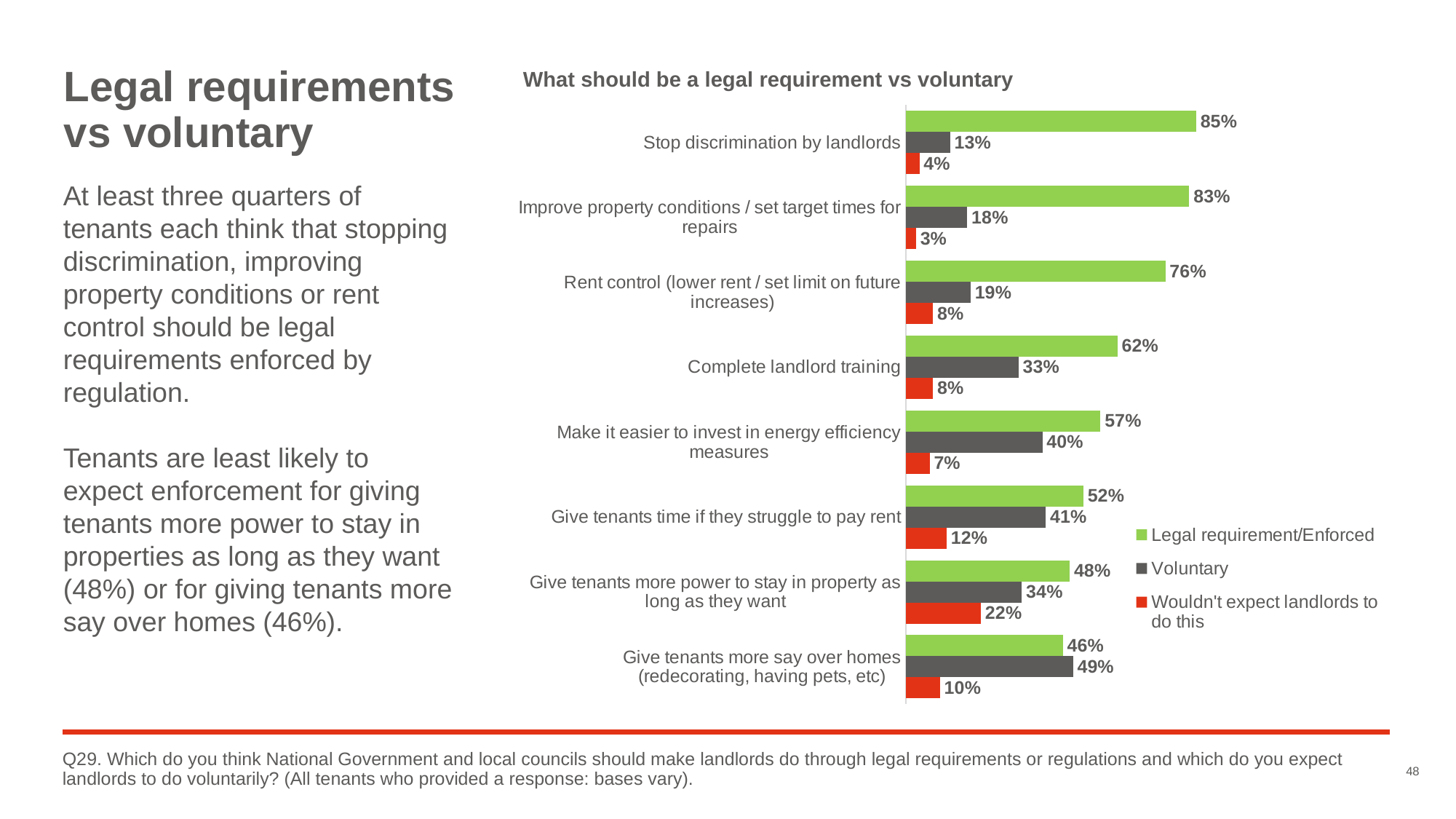
How many categories are shown on the chart? 8 What is the difference between the 'Legal requirement/Enforced' and 'Voluntary' values for 'Rent control (lower rent / set limit on future increases)'? 57% Which category has the lowest 'Wouldn't expect landlords to do this' value? Improve property conditions / set target times for repairs For 'Give tenants more say over homes (redecorating, having pets, etc)', which is larger: the 'Legal requirement/Enforced' value or the 'Voluntary' value? Voluntary What percentage of tenants wouldn't expect landlords to 'Give tenants more power to stay in property as long as they want'? 22% What is the 'Voluntary' value for 'Complete landlord training'? 33% What type of chart is shown on the slide? Bar chart How many series does the legend list? 3 Which colour represents the 'Voluntary' series in the chart? Dark grey What percentage of tenants think 'Stop discrimination by landlords' should be a legal requirement/enforced? 85% What is the title of the chart? What should be a legal requirement vs voluntary Which category has the highest 'Legal requirement/Enforced' value? Stop discrimination by landlords